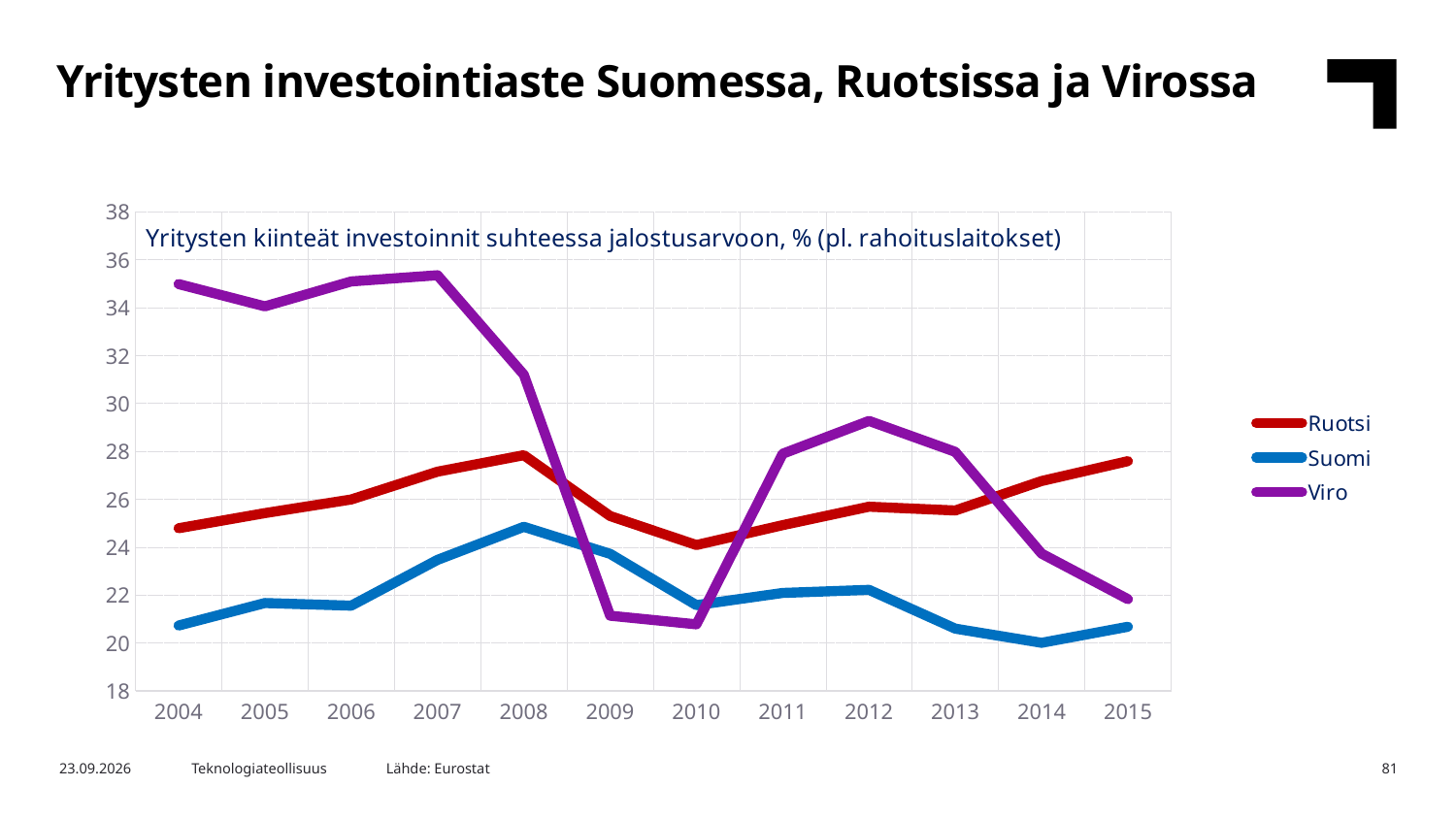
Does the value for Viro rise or fall from 2008 to 2009? fall Is the value for Viro in 2010 greater or less than 22? less Which series has the highest value in 2004? Viro Is the value for Ruotsi in 2008 greater or less than 26? greater What kind of chart is shown on the slide? line chart In 2010, which is larger, the value for Ruotsi or the value for Viro? Ruotsi How many series does the legend list? 3 Is the value for Viro in 2004 greater or less than 34? greater Which series has the highest value in 2012? Viro In which year does Suomi reach its highest value? 2008 How many years are shown on the x axis? 12